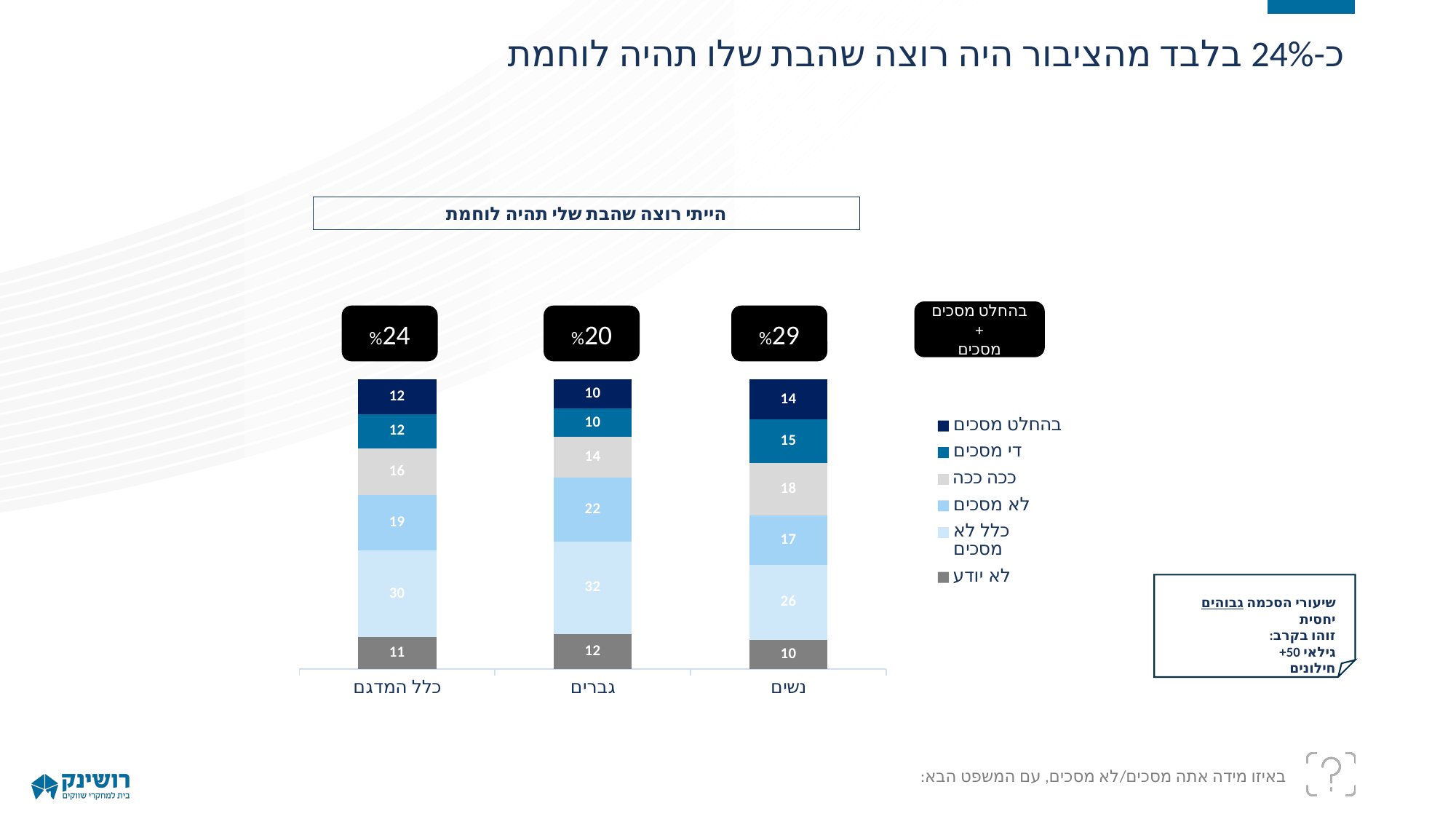
What is the value of the 'לא יודע' segment for 'כלל המדגם'? 11 Which category has the lowest combined 'בהחלט מסכים + מסכים' percentage shown in the black boxes? גברים What kind of chart is shown on the slide? stacked bar chart Which category has the highest combined 'בהחלט מסכים + מסכים' percentage shown in the black boxes? נשים What combined percentage of 'בהחלט מסכים + מסכים' is shown in the black box above the 'נשים' bar? %29 How many categories are shown along the x axis of the chart? 3 What is the total of the stacked bar for 'כלל המדגם'? 100 How many series does the chart legend list? 6 What is the value of the 'בהחלט מסכים' segment for 'נשים'? 14 What is the difference between the 'לא מסכים' values for 'גברים' and 'נשים'? 5 Which is larger: the 'ככה ככה' value for 'נשים' or for 'גברים'? נשים What is the value of the 'כלל לא מסכים' segment for 'גברים'? 32